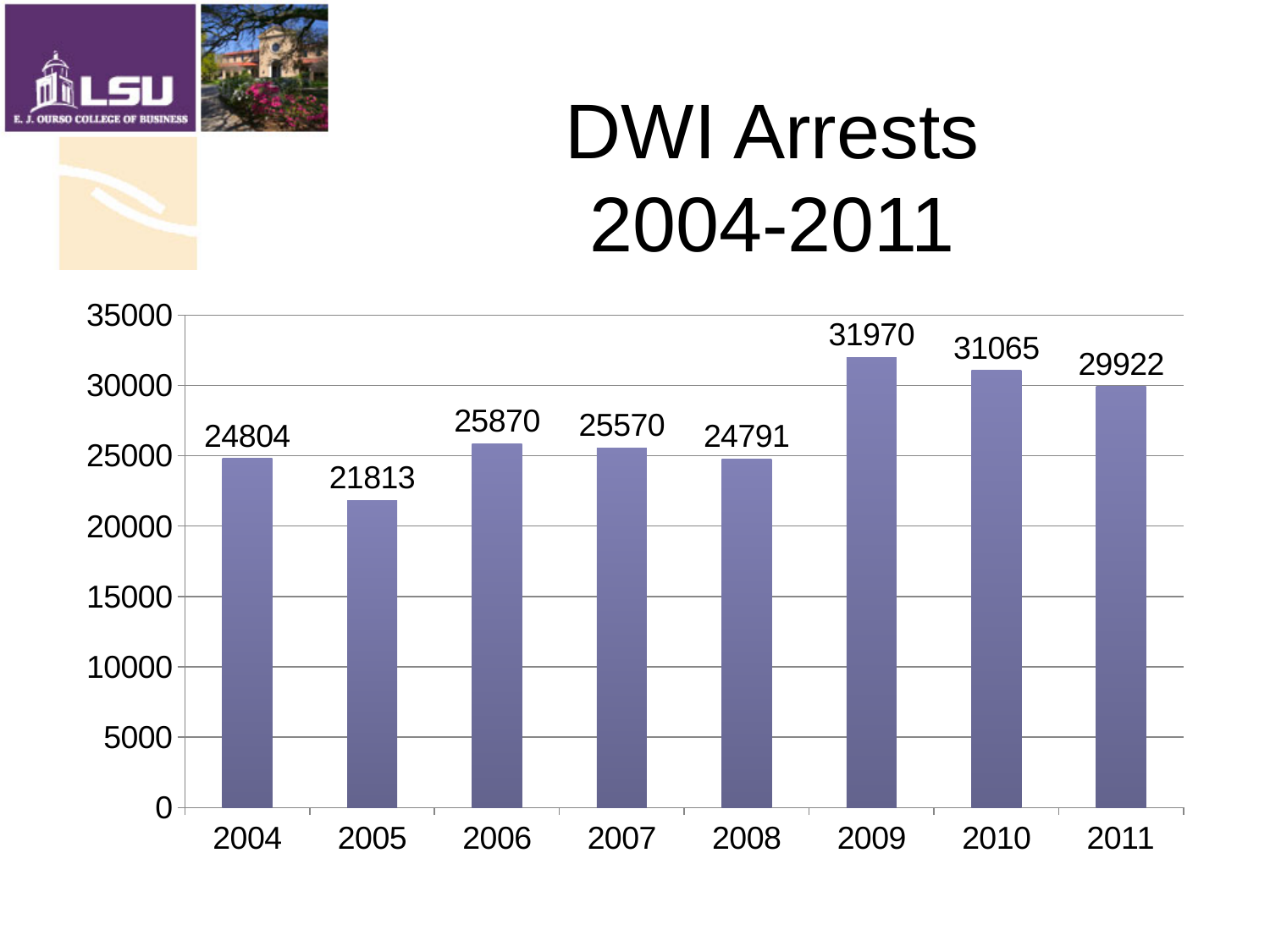
What was the number of DWI arrests in 2011? 29922 What was the number of DWI arrests in 2005? 21813 What was the number of DWI arrests in 2009? 31970 Which year had more DWI arrests, 2004 or 2008? 2004 What is the difference in DWI arrests between 2009 and 2010? 905 How many years are shown on the chart? 8 Which year had the highest number of DWI arrests? 2009 What is the title of the chart? DWI Arrests 2004-2011 What is the difference in DWI arrests between 2006 and 2005? 4057 Which year had the lowest number of DWI arrests? 2005 What kind of chart is shown on the slide? Bar chart Is the value for 2010 greater or less than 30000? greater